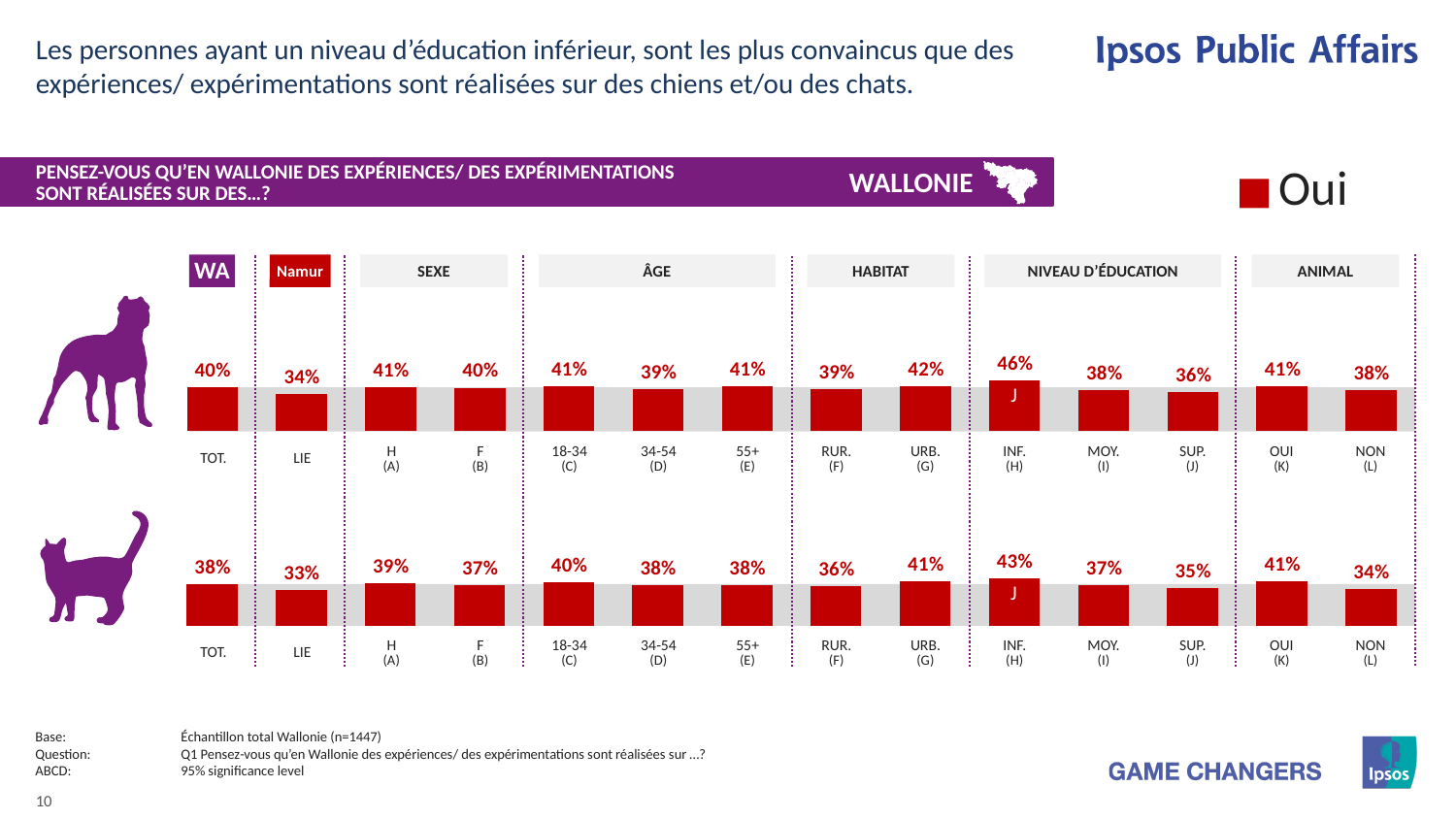
In the top (dog) chart, what is the value for URB. (G)? 42% In the top (dog) chart, what is the difference between INF. (H) and SUP. (J)? 10% In the bottom (cat) chart, which category has the lowest value? LIE (Namur) In the top (dog) chart, which is larger, RUR. (F) or URB. (G)? URB. (G) In the bottom (cat) chart, what is the value for Namur (LIE)? 33% In the bottom (cat) chart, what is the value for INF. (H) under Niveau d'éducation? 43% In the bottom (cat) chart, which is larger, H (A) or F (B)? H (A) What type of chart is used on this slide? Bar chart In the bottom (cat) chart, what is the difference between OUI (K) and NON (L) under Animal? 7% What is the only legend entry shown on the slide? Oui In the top (dog) chart, which education level has the highest value? INF. (H) In the top (dog) chart, what is the value for TOT.? 40%